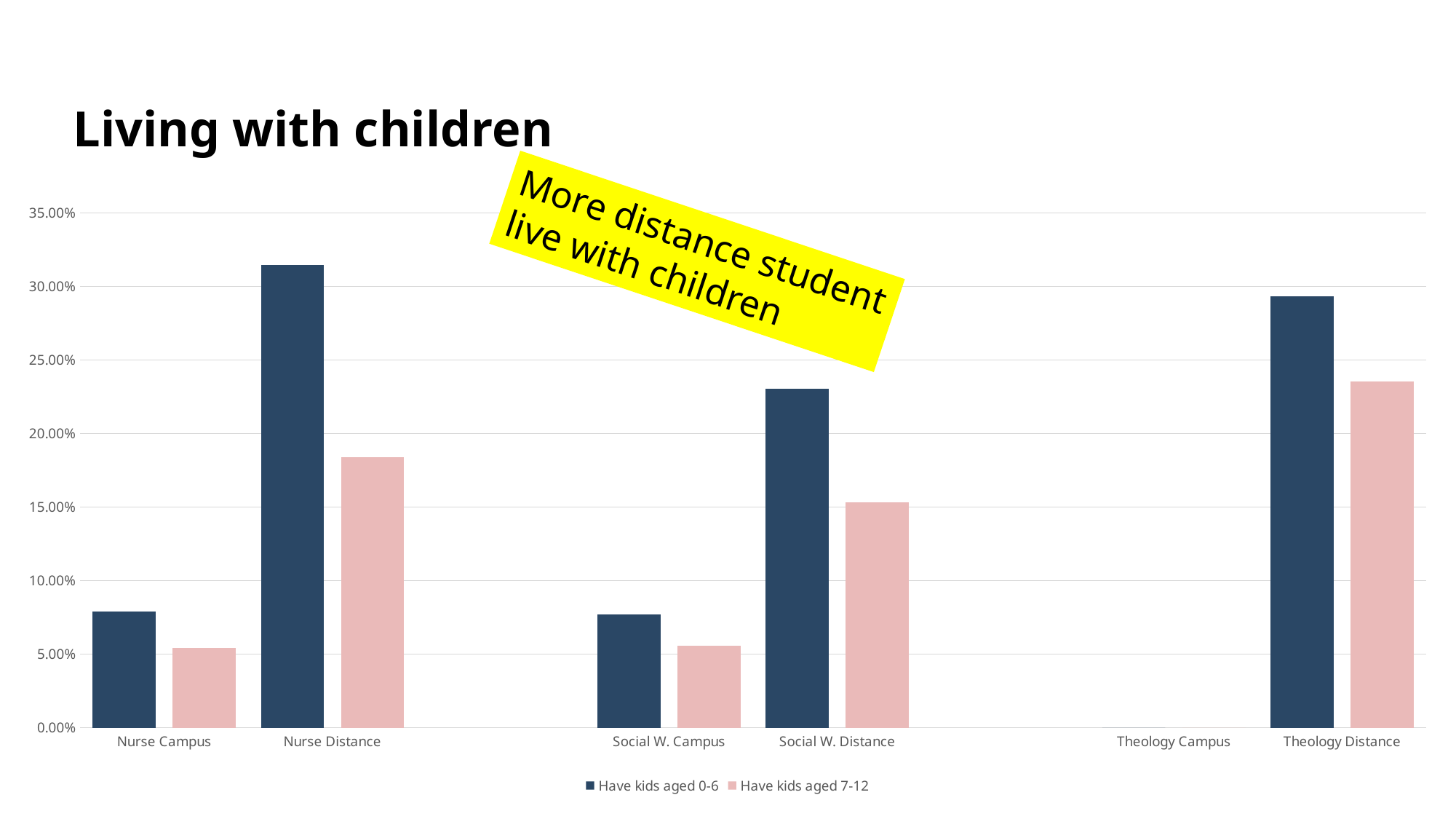
Which category has the highest value for 'Have kids aged 7-12'? Theology Distance How many categories are labelled on the x axis? 6 How many series does the legend list? 2 What is the title of the slide? Living with children Is the value for 'Have kids aged 0-6' at Nurse Distance greater or less than 30.00%? greater Which category has the highest value for 'Have kids aged 0-6'? Nurse Distance Which is larger: 'Have kids aged 7-12' at Nurse Distance or 'Have kids aged 7-12' at Social W. Distance? Nurse Distance Is the value for 'Have kids aged 7-12' at Theology Distance greater or less than 20.00%? greater What kind of chart is shown on the slide? bar chart Which is larger: 'Have kids aged 0-6' at Nurse Distance or 'Have kids aged 0-6' at Social W. Distance? Nurse Distance Is the value for 'Have kids aged 0-6' at Social W. Distance greater or less than 20.00%? greater